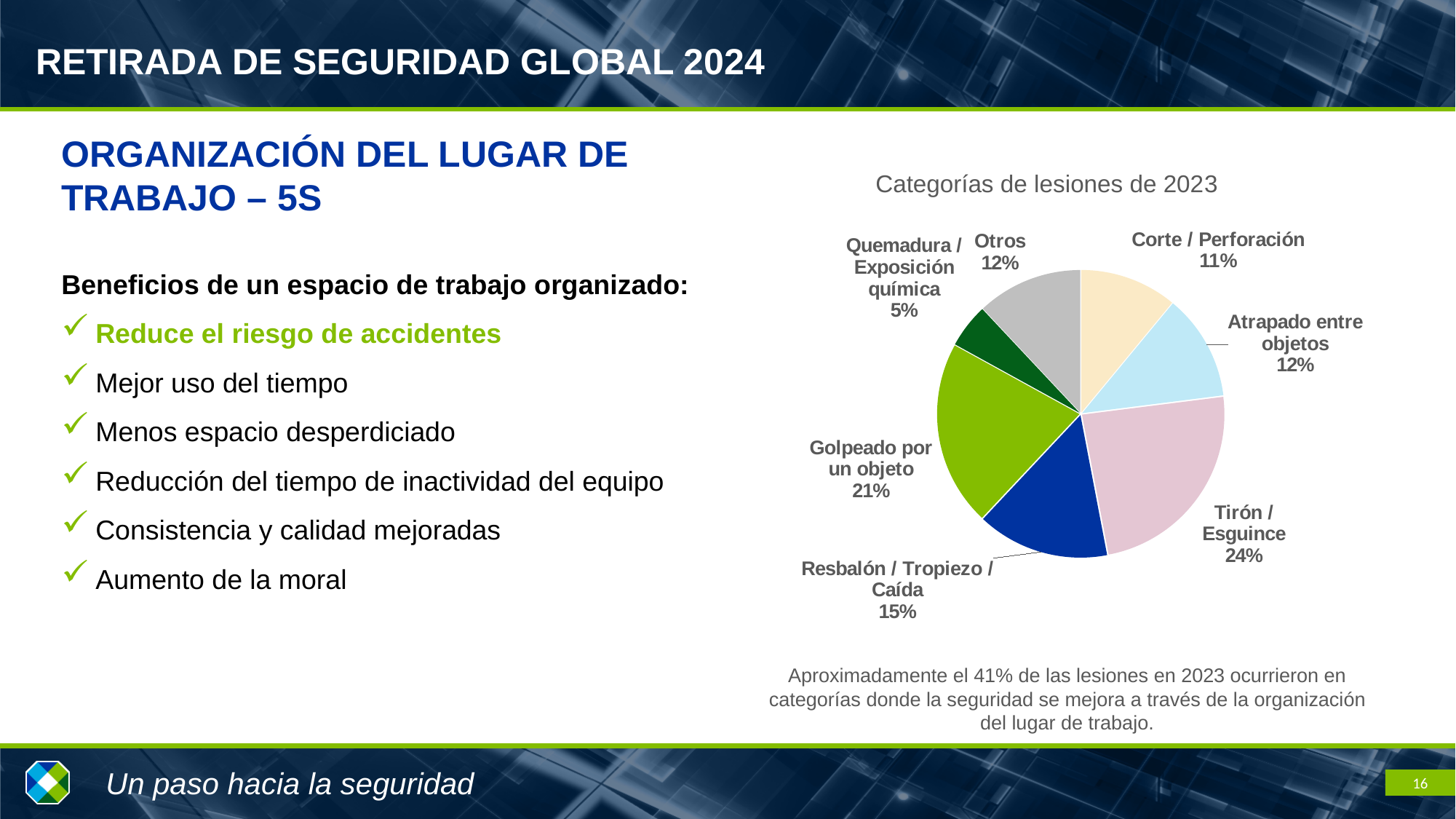
Which injury category has the largest share of the pie? Tirón / Esguince What percentage of injuries is attributed to Resbalón / Tropiezo / Caída? 15% What percentage of injuries is attributed to Quemadura / Exposición química? 5% What percentage of injuries is attributed to Tirón / Esguince? 24% What is the title of the chart? Categorías de lesiones de 2023 How many injury categories are shown in the pie chart? 7 What is the combined share of Otros and Atrapado entre objetos? 24% Which has a larger share: Corte / Perforación or Resbalón / Tropiezo / Caída? Resbalón / Tropiezo / Caída What type of chart is shown on the slide? Pie chart What is the difference in percentage points between Tirón / Esguince and Golpeado por un objeto? 3 What percentage of injuries is attributed to Golpeado por un objeto? 21% Which injury category has the smallest share of the pie? Quemadura / Exposición química